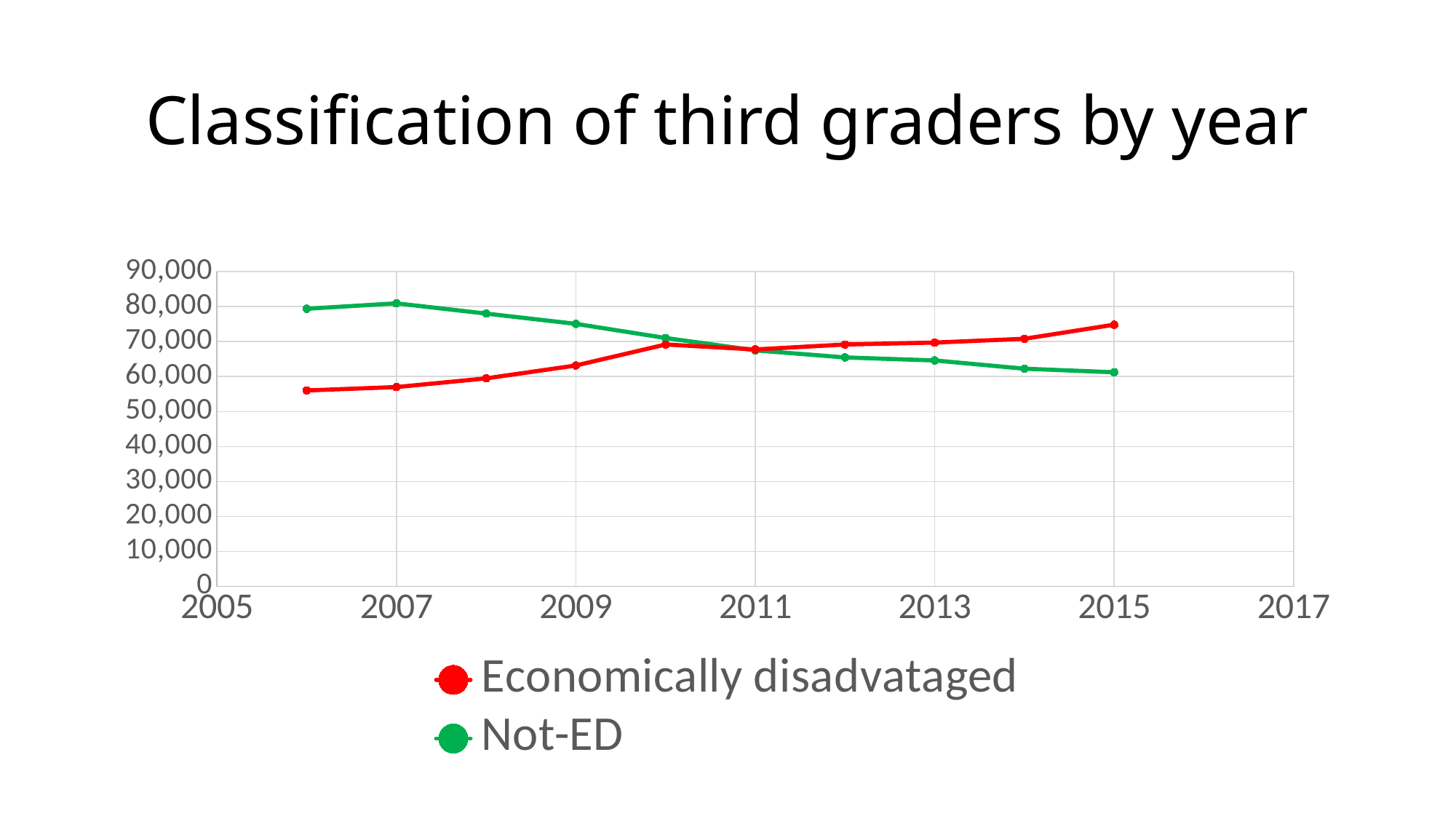
How many series does the legend list? 2 Is the Economically disadvataged value for 2006 greater or less than 60,000? less What kind of chart is shown on the slide? line chart Which colour is used for the Not-ED series? green How many data points are plotted for the Economically disadvataged series? 10 What is the title of the chart? Classification of third graders by year In 2008, which series has the larger value, Economically disadvataged or Not-ED? Not-ED Does the Economically disadvataged series rise or fall from 2006 to 2010? rise In which year does the Not-ED series reach its highest value? 2007 In 2015, which series has the larger value, Economically disadvataged or Not-ED? Economically disadvataged Does the Not-ED series rise or fall from 2007 to 2015? fall